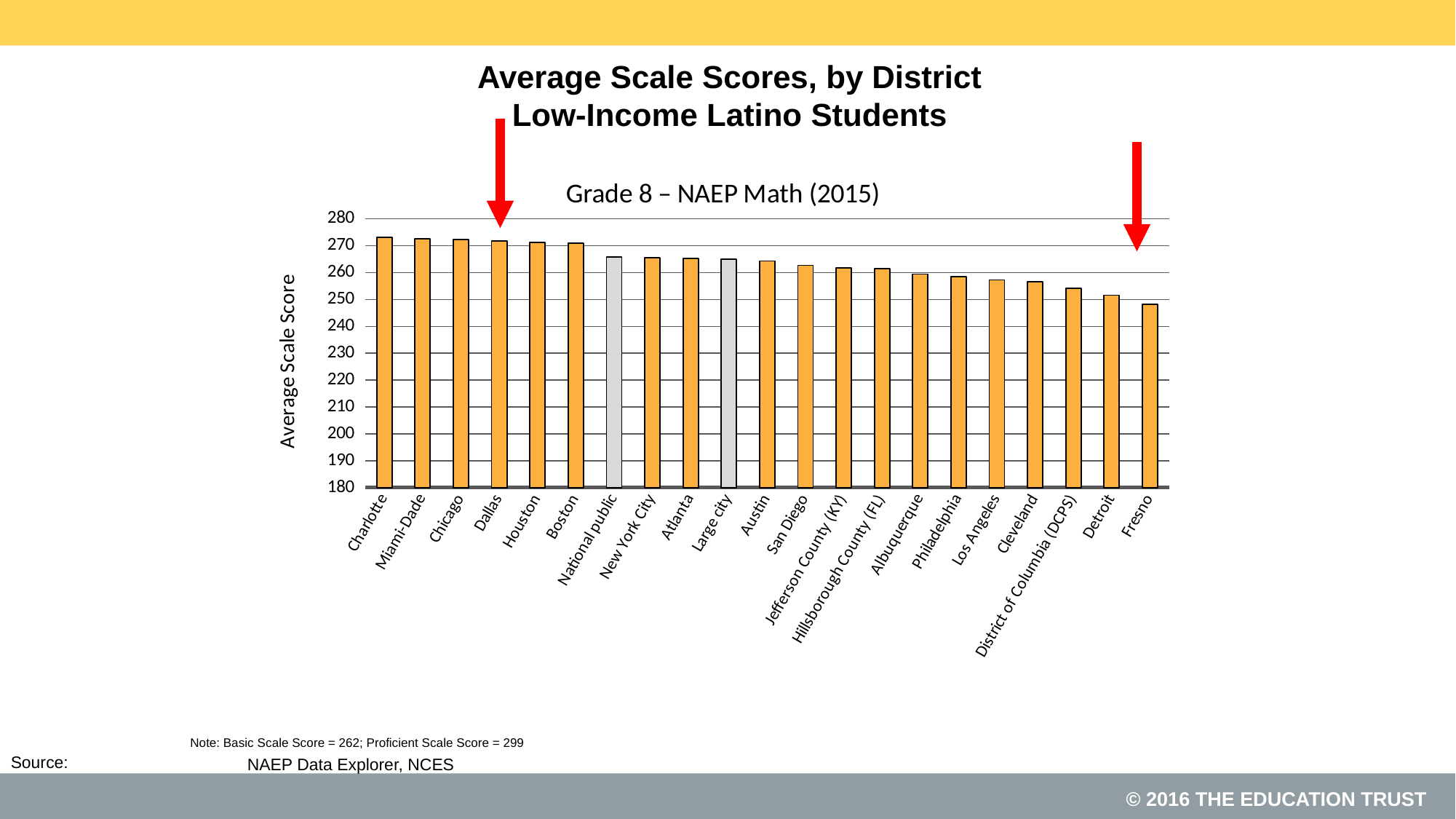
Do the values rise or fall moving from left to right along the x axis? fall What is the label on the vertical axis? Average Scale Score What kind of chart is shown on the slide? bar chart Which has a higher average scale score, Boston or Cleveland? Boston Which two bars are shaded grey instead of orange? National public and Large city Which has a higher average scale score, Dallas or Detroit? Dallas Is the value for Charlotte greater or less than 270? greater Is the value for Los Angeles greater or less than 260? less Is the value for National public greater or less than 260? greater How many districts or groups are plotted on the chart? 21 Which district has the lowest average scale score? Fresno